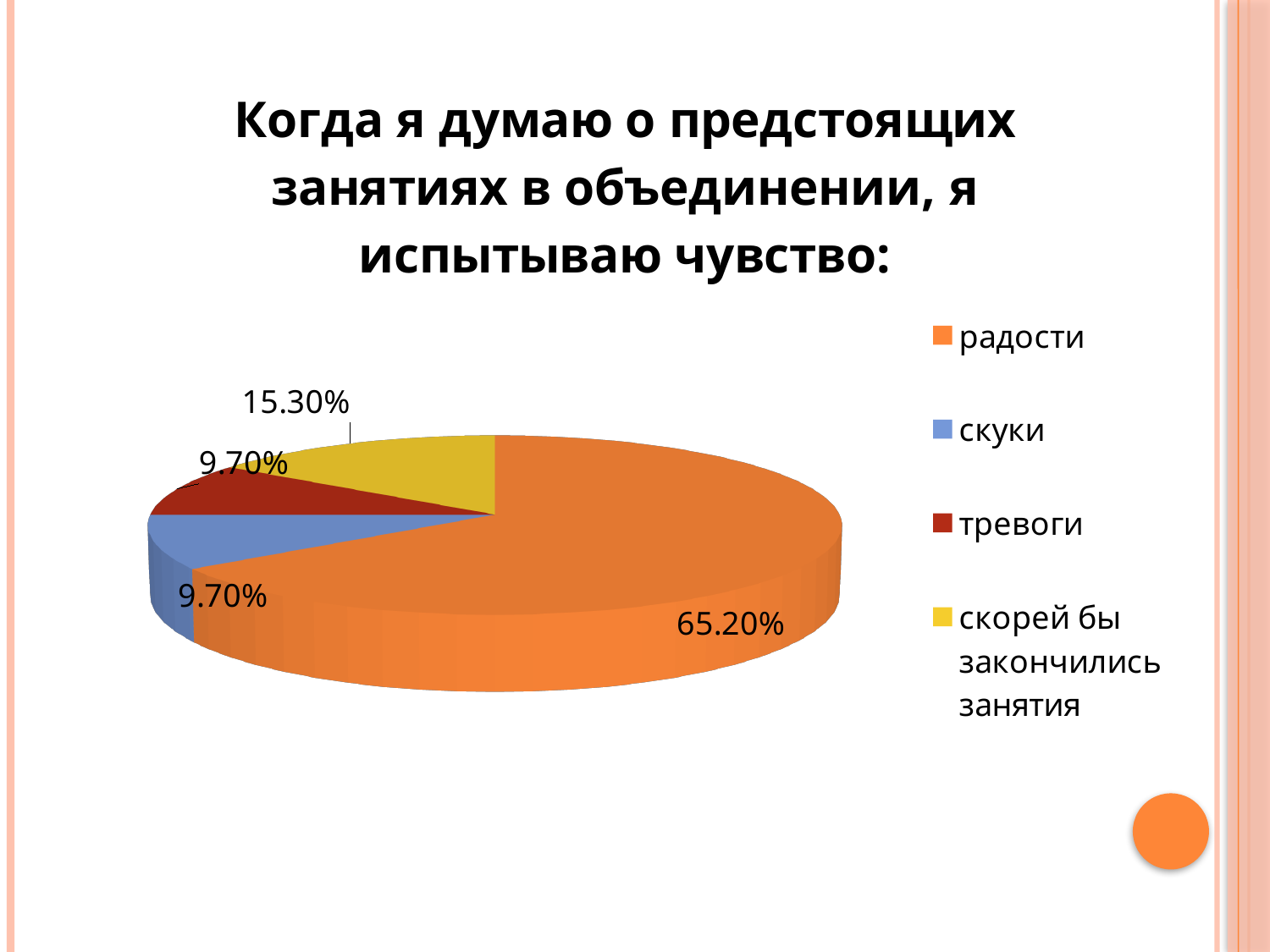
What percentage of respondents chose "радости"? 65.20% How many entries does the legend list? 4 How many categories does the pie chart have? 4 What percentage of respondents chose "скуки"? 9.70% What percentage of respondents chose "тревоги"? 9.70% What colour is the slice for "тревоги"? dark red What is the difference between the share for "радости" and the share for "скорей бы закончились занятия"? 49.90% What percentage of respondents chose "скорей бы закончились занятия"? 15.30% Which is larger: the share for "скорей бы закончились занятия" or the share for "скуки"? скорей бы закончились занятия What is the title of the chart? Когда я думаю о предстоящих занятиях в объединении, я испытываю чувство: Which category has the largest share of the pie? радости What kind of chart is shown on the slide? pie chart